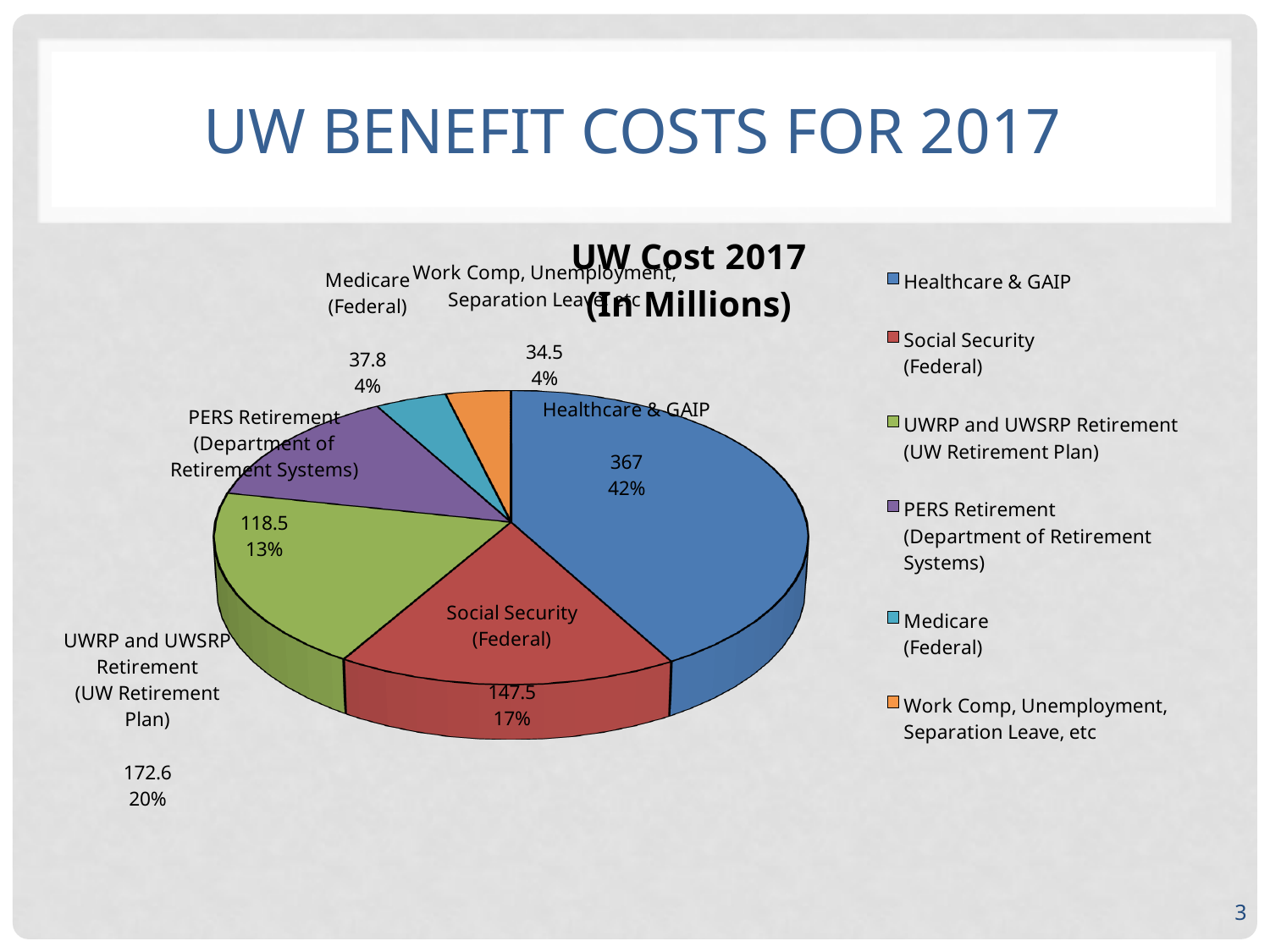
What is the difference between the values for Healthcare & GAIP and Social Security (Federal)? 219.5 What type of chart is shown on the slide? Pie chart Which category has the smallest value? Work Comp, Unemployment, Separation Leave, etc What share of the pie does Medicare (Federal) represent? 4% What is the value for PERS Retirement (Department of Retirement Systems)? 118.5 Which is larger, the value for UWRP and UWSRP Retirement (UW Retirement Plan) or the value for PERS Retirement (Department of Retirement Systems)? UWRP and UWSRP Retirement (UW Retirement Plan) What share of the pie does Healthcare & GAIP represent? 42% What is the value for Social Security (Federal)? 147.5 Which category has the largest slice of the pie? Healthcare & GAIP What is the value for Healthcare & GAIP? 367 How many categories does the pie chart have? 6 What is the value for UWRP and UWSRP Retirement (UW Retirement Plan)? 172.6